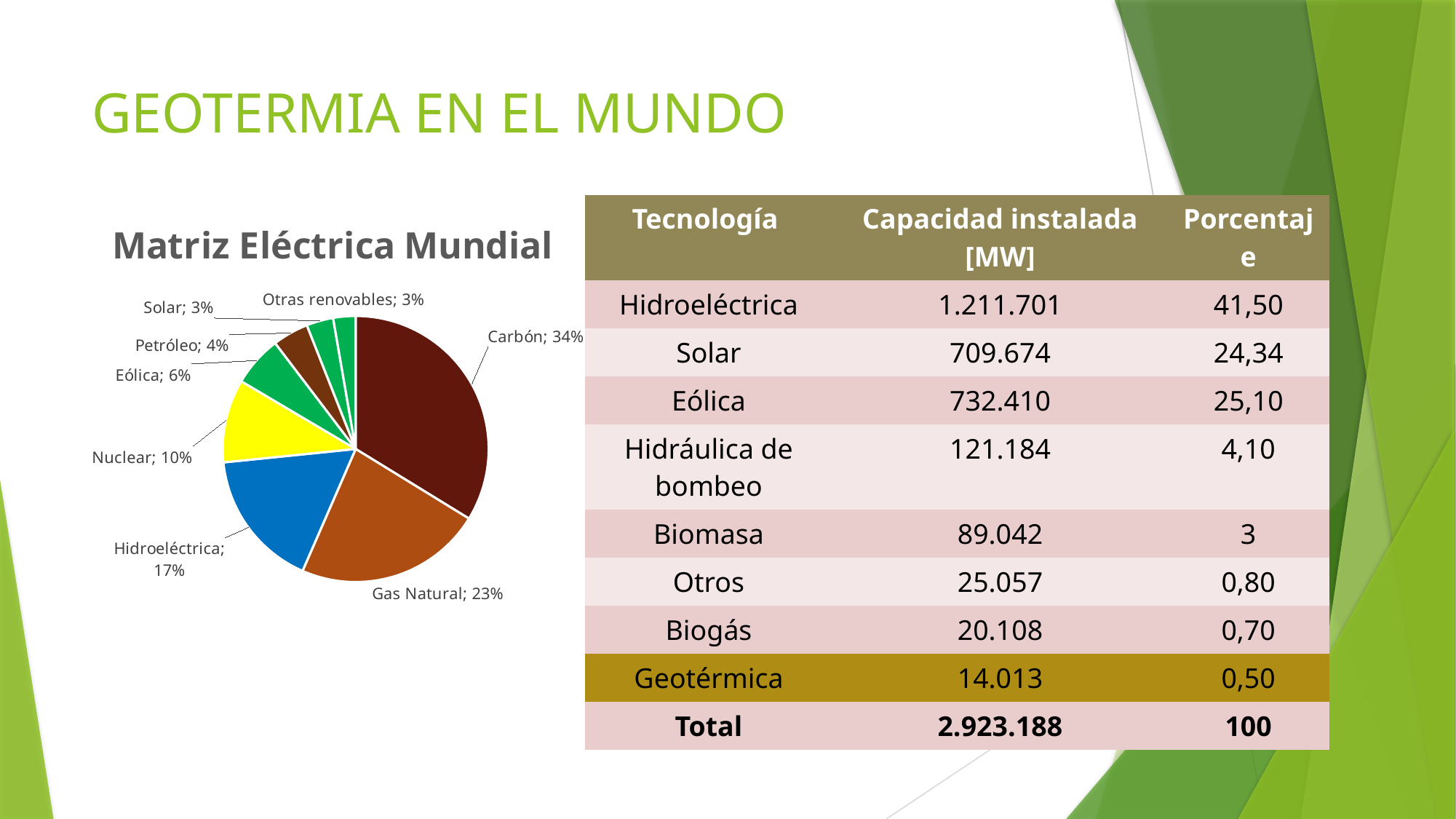
In the Matriz Eléctrica Mundial pie chart, how many slices are there? 8 In the Matriz Eléctrica Mundial pie chart, which category has the largest share? Carbón In the Matriz Eléctrica Mundial pie chart, what is the difference between the shares of Carbón and Gas Natural? 11% In the Matriz Eléctrica Mundial pie chart, what share does Eólica have? 6% In the Matriz Eléctrica Mundial pie chart, what share does Hidroeléctrica have? 17% In the Matriz Eléctrica Mundial pie chart, which is larger, Nuclear or Eólica? Nuclear What is the title of the pie chart on the slide? Matriz Eléctrica Mundial In the Matriz Eléctrica Mundial pie chart, what share does Carbón have? 34% In the Matriz Eléctrica Mundial pie chart, what share does Gas Natural have? 23% What kind of chart is shown on the left of the slide? pie chart In the Matriz Eléctrica Mundial pie chart, what share does Petróleo have? 4% In the Matriz Eléctrica Mundial pie chart, what share does Nuclear have? 10%